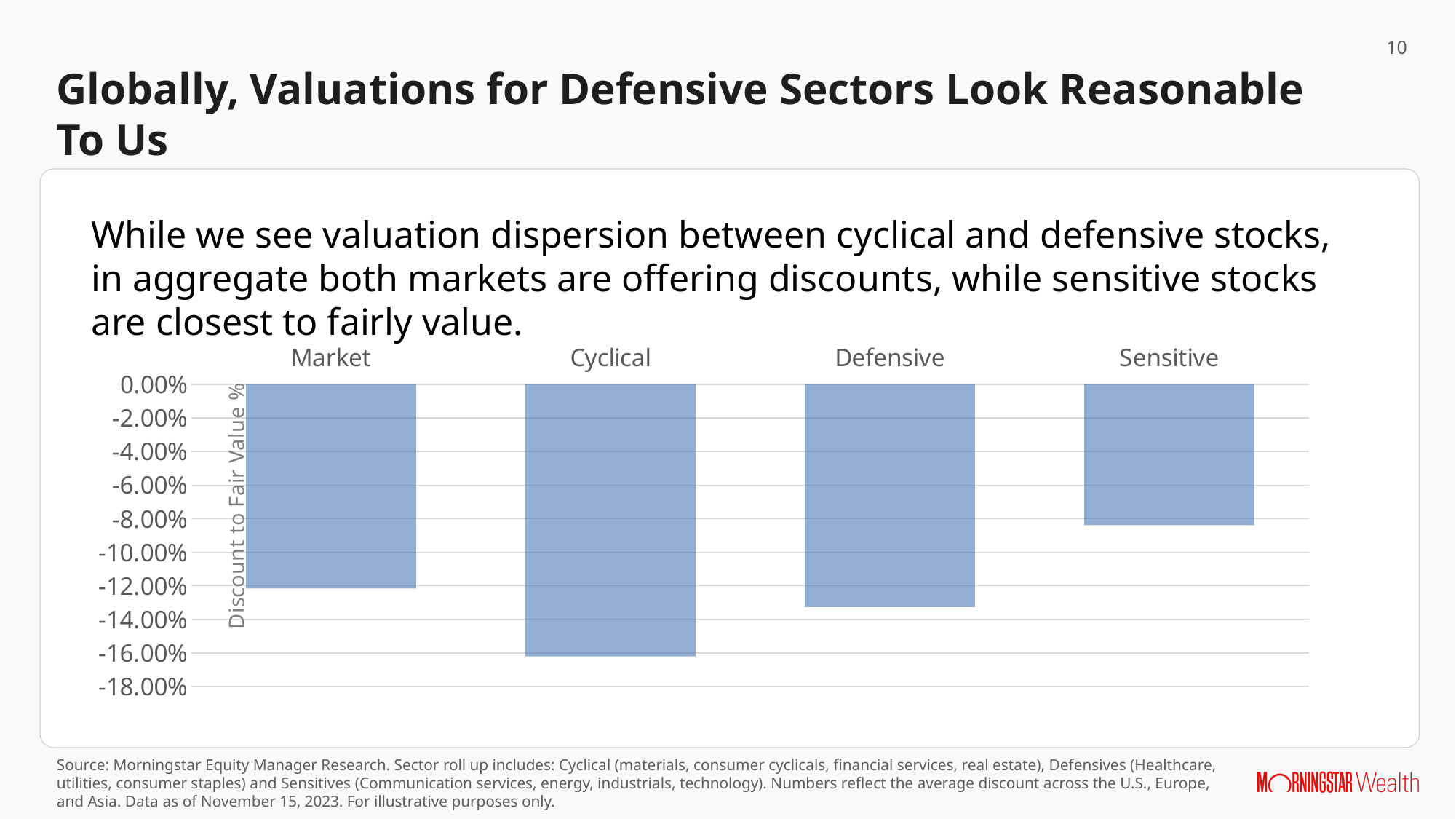
Is the value for Cyclical greater or less than -14.00%? less Which has the higher (less negative) value, Market or Sensitive? Sensitive Is the value for Sensitive greater or less than -6.00%? less Which category has the highest (least negative) value in the chart? Sensitive Is the value for Defensive greater or less than -12.00%? less Which category has the lowest (most negative) value in the chart? Cyclical What kind of chart is shown on the slide? bar chart How many categories are plotted in the chart? 4 Which has the larger discount to fair value (more negative value), Cyclical or Defensive? Cyclical What is the title of the vertical axis of the chart? Discount to Fair Value %